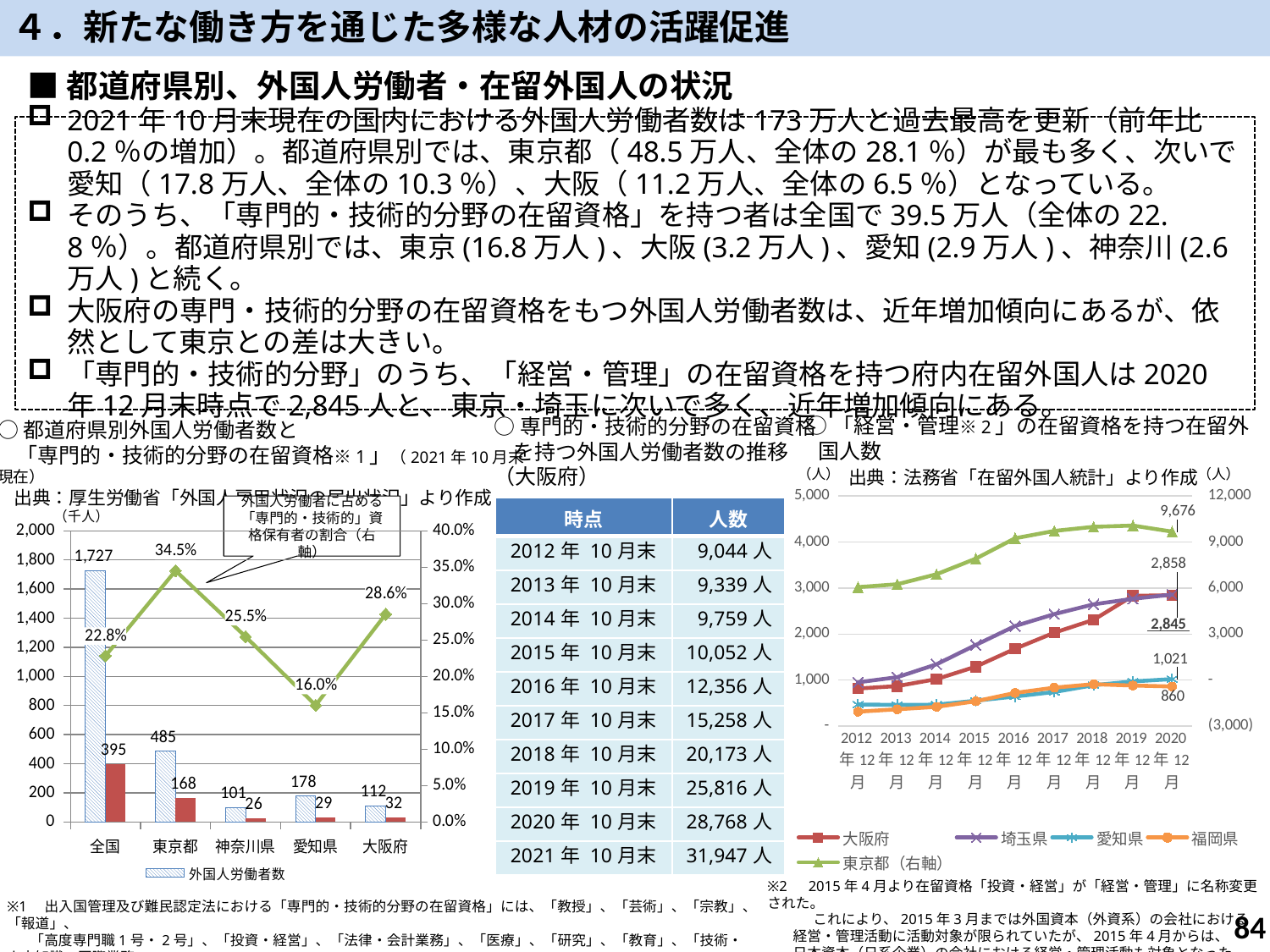
In the right chart, does the 大阪府 line rise or fall from 2012年12月 to 2020年12月? Rise What kind of chart is the left chart (都道府県別外国人労働者数)? Combined bar and line chart In the right chart, what is the value labelled for 大阪府 in 2020年12月? 2,845 In the left chart, what is the share of 「専門的・技術的」資格保有者 (the line, right axis) for 愛知県? 16.0% In the left chart, which is larger: the red bar for 大阪府 or the red bar for 神奈川県? 大阪府 In the left chart, how many categories are shown on the x axis? 5 In the left chart, which category has the lowest share of 「専門的・技術的」資格保有者 on the line? 愛知県 In the right chart, how many series does the legend list? 5 In the left chart (都道府県別外国人労働者数と「専門的・技術的分野の在留資格」), what is the number of foreign workers (外国人労働者数) for 東京都? 485 In the left chart, what is the difference between the 外国人労働者数 bar for 愛知県 (178) and for 大阪府 (112)? 66 In the left chart, which prefecture (excluding 全国) has the highest share of 「専門的・技術的」資格保有者 on the line? 東京都 In the right chart (「経営・管理」の在留資格を持つ在留外国人数), what is the value labelled for 東京都 in 2020年12月? 9,676